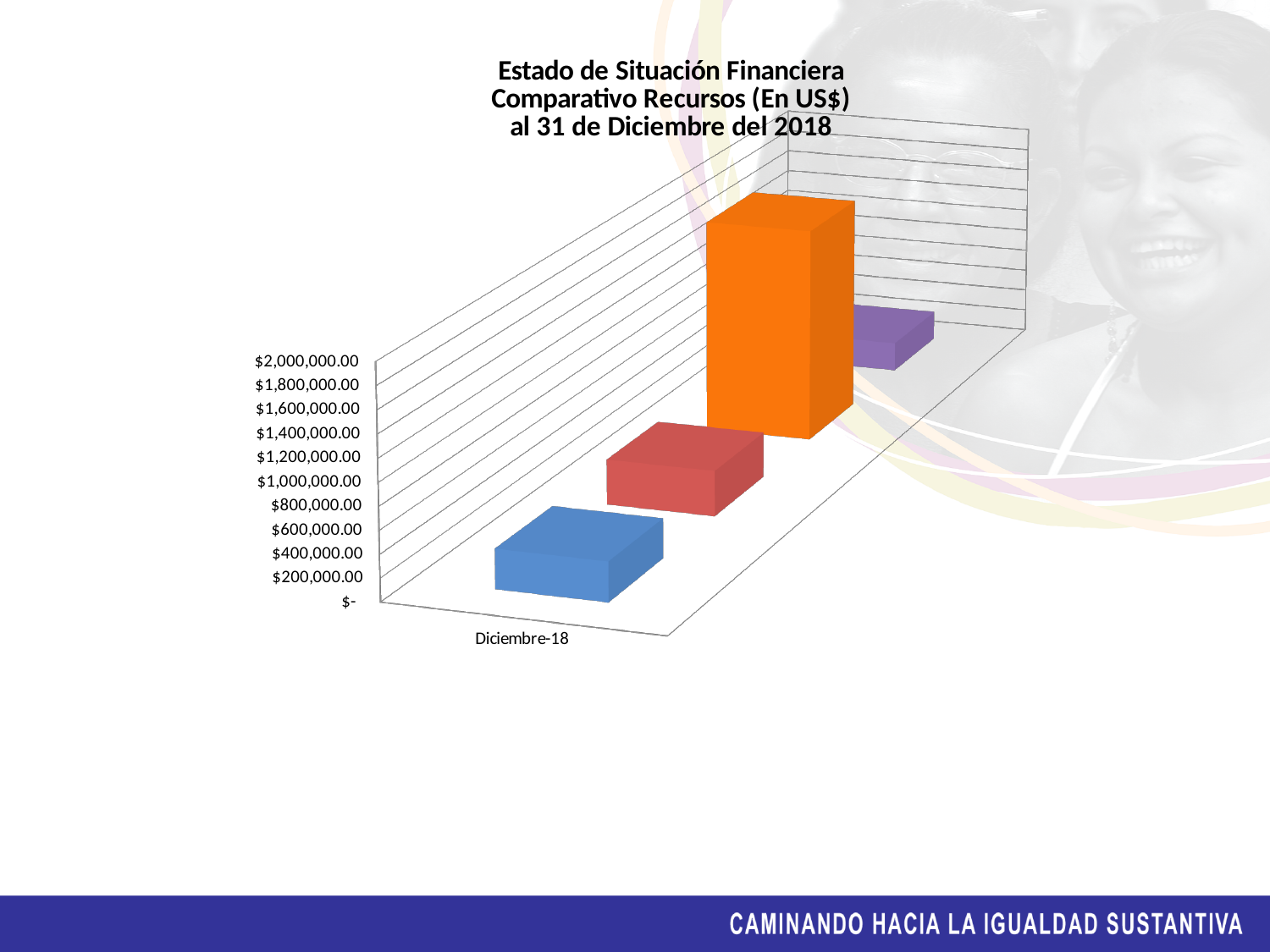
Which coloured bar is the tallest in the chart? orange What kind of chart is shown on the slide? bar chart How many categories are shown on the horizontal axis of the chart? 1 What is the title of the chart? Estado de Situación Financiera Comparativo Recursos (En US$) al 31 de Diciembre del 2018 What is the label of the category shown on the horizontal axis? Diciembre-18